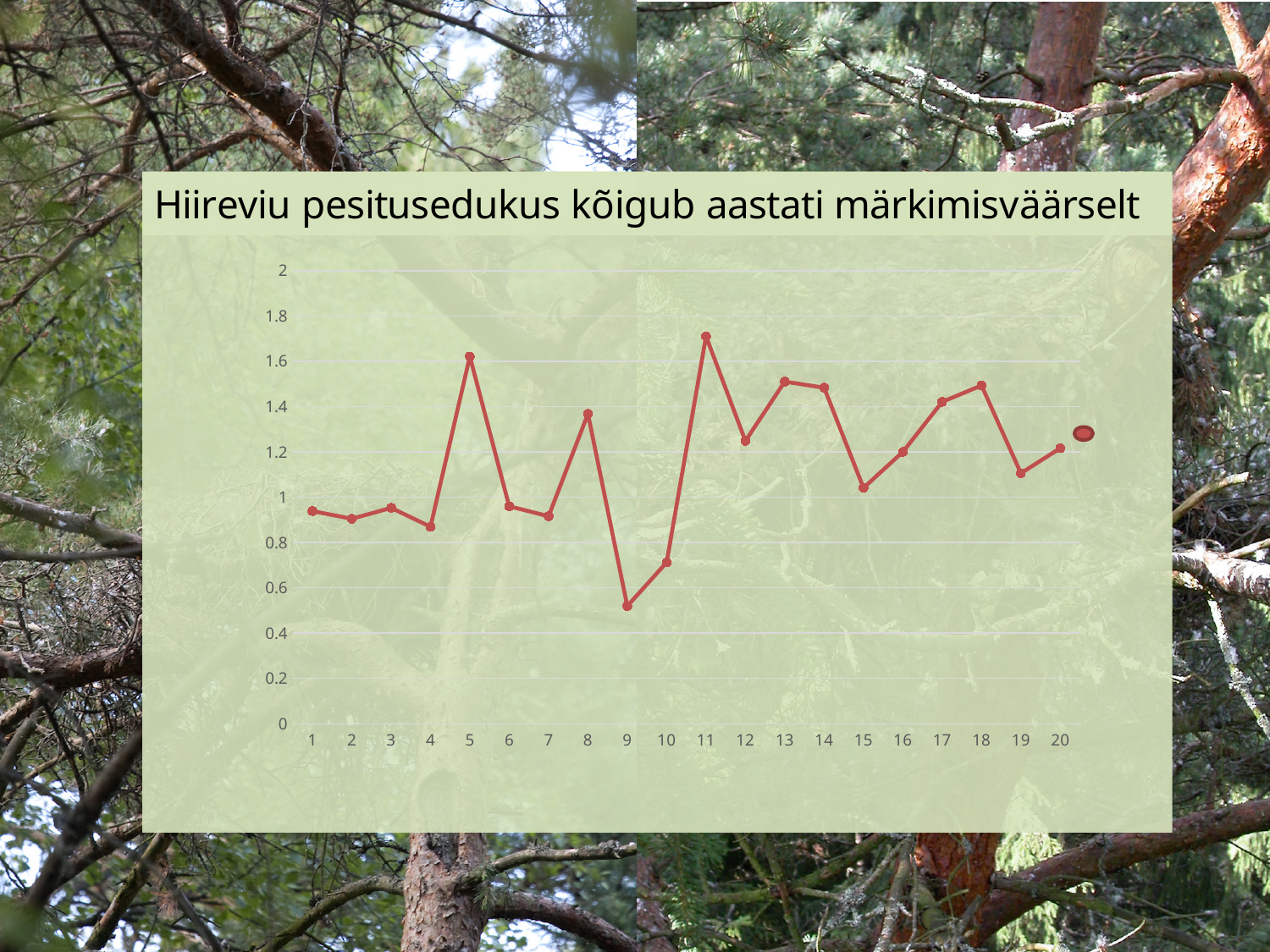
At which x-axis point does the line reach its highest value? 11 Is the value at point 9 greater or less than 0.8? less How many points are plotted along the x axis? 20 What kind of chart is shown on the slide? line chart What is the title of the chart? Hiireviu pesitusedukus kõigub aastati märkimisväärselt At which x-axis point does the line reach its lowest value? 9 Does the line rise or fall from point 9 to point 11? rises Which has the larger value, point 9 or point 10? point 10 Is the value at point 11 greater or less than 1.6? greater Is the value at point 13 greater or less than 1.4? greater Which has the larger value, point 5 or point 8? point 5